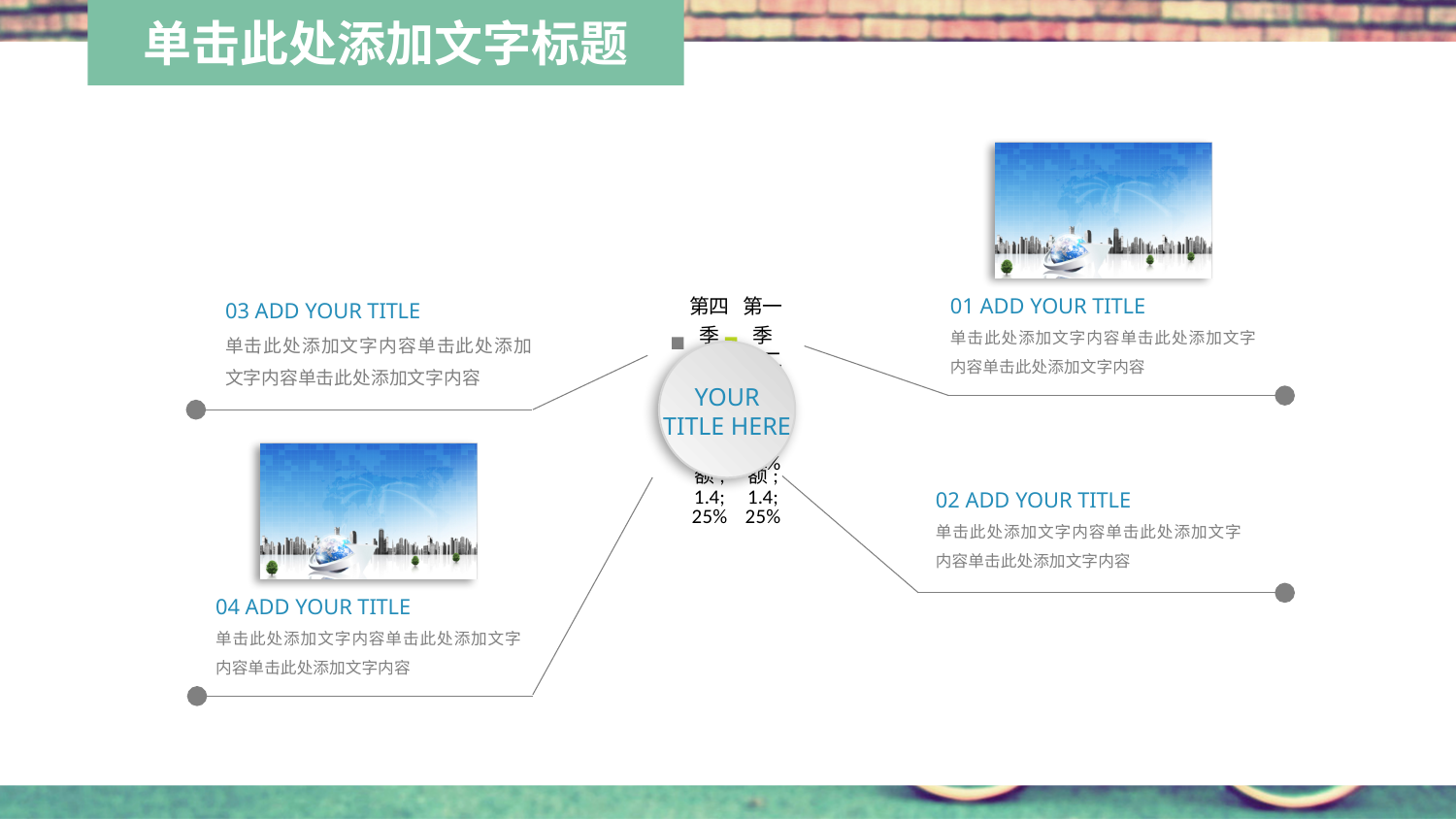
What percentage is shown in the data labels visible below the central 'YOUR TITLE HERE' circle? 25% Which two legend entries are readable above the central circle? 第四季 and 第一季 Do the two visible data labels show the same percentage or different percentages? the same What numeric value appears in the data labels visible below the central circle? 1.4